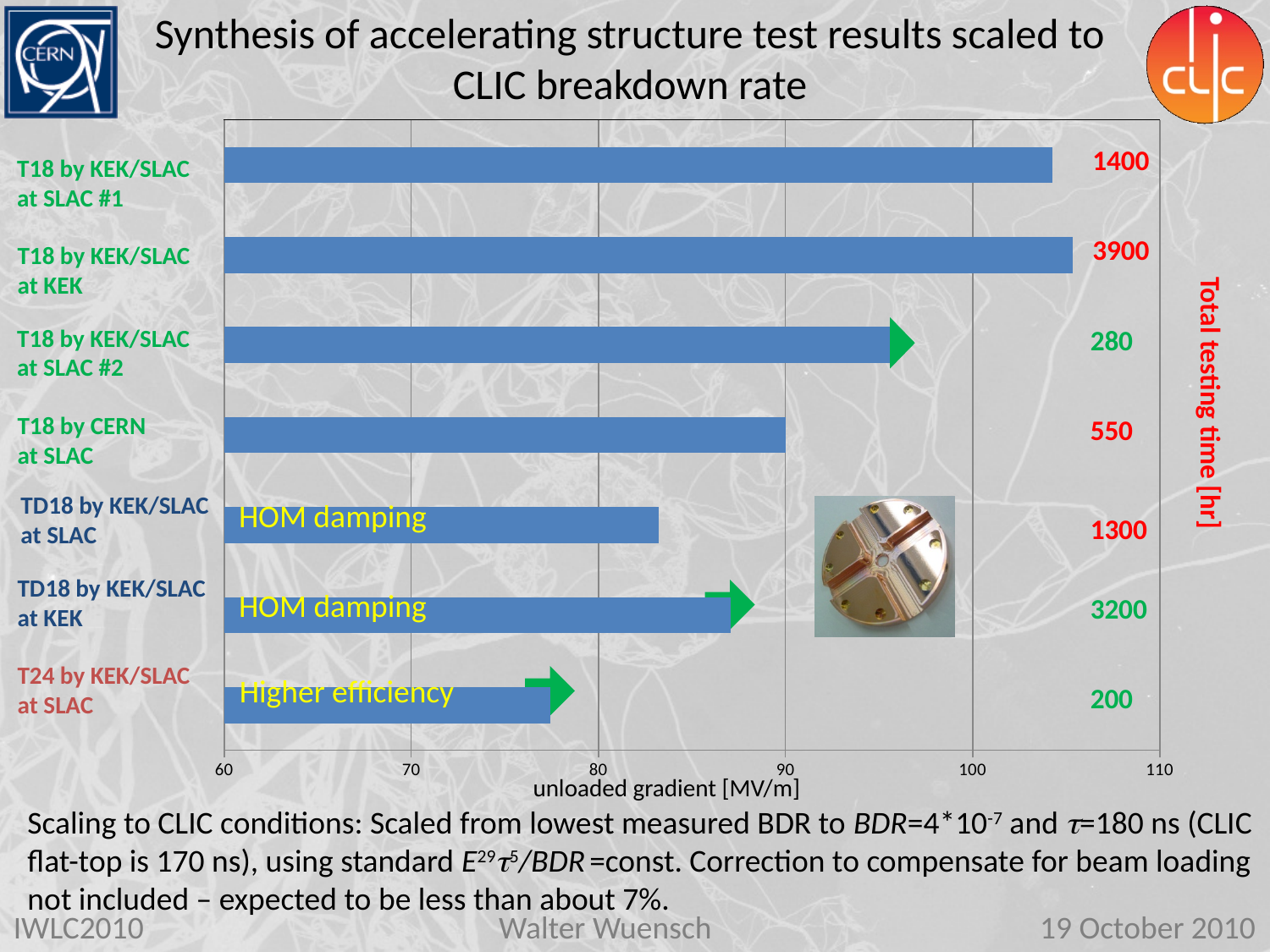
What total testing time in hours is listed for T18 by KEK/SLAC at KEK? 3900 Which has the larger unloaded gradient: TD18 by KEK/SLAC at KEK or TD18 by KEK/SLAC at SLAC? TD18 by KEK/SLAC at KEK Is the unloaded gradient for TD18 by KEK/SLAC at KEK greater or less than 90 MV/m? less How many accelerating structures (categories) are plotted in the chart? 7 What is the label of the horizontal axis of the chart? unloaded gradient [MV/m] What kind of chart is shown on the slide? bar chart What total testing time in hours is listed for T24 by KEK/SLAC at SLAC? 200 Is the unloaded gradient for T18 by KEK/SLAC at SLAC #1 greater or less than 100 MV/m? greater Is the unloaded gradient for T24 by KEK/SLAC at SLAC greater or less than 80 MV/m? less Which structure has the lowest unloaded gradient in the chart? T24 by KEK/SLAC at SLAC Which structure has the highest unloaded gradient in the chart? T18 by KEK/SLAC at KEK What is the difference in total testing time between T18 by KEK/SLAC at KEK (3900 hr) and T18 by KEK/SLAC at SLAC #1 (1400 hr)? 2500